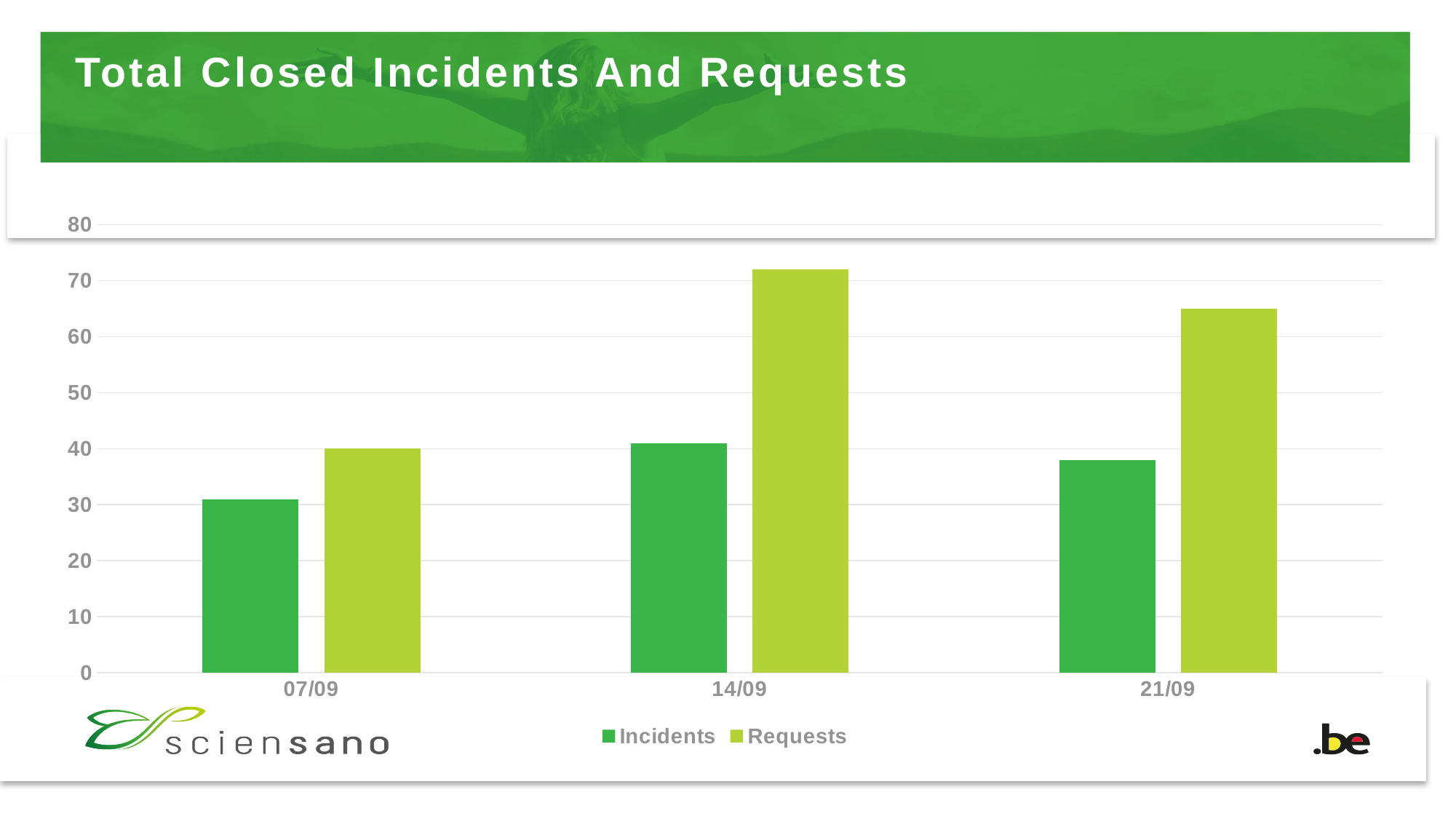
What kind of chart is shown on the slide? bar chart Which date has the highest value for Requests? 14/09 How many series does the chart legend list? 2 What is the title of the chart? Total Closed Incidents And Requests On 14/09, which is larger, Incidents or Requests? Requests Which date has the lowest value for Requests? 07/09 Is the value for Requests on 14/09 greater or less than 70? greater Is the value for Incidents on 07/09 greater or less than 40? less Which date has the lowest value for Incidents? 07/09 How many dates are shown on the x axis of the chart? 3 Is the value for Requests on 21/09 greater or less than 60? greater On 21/09, which is larger, Incidents or Requests? Requests